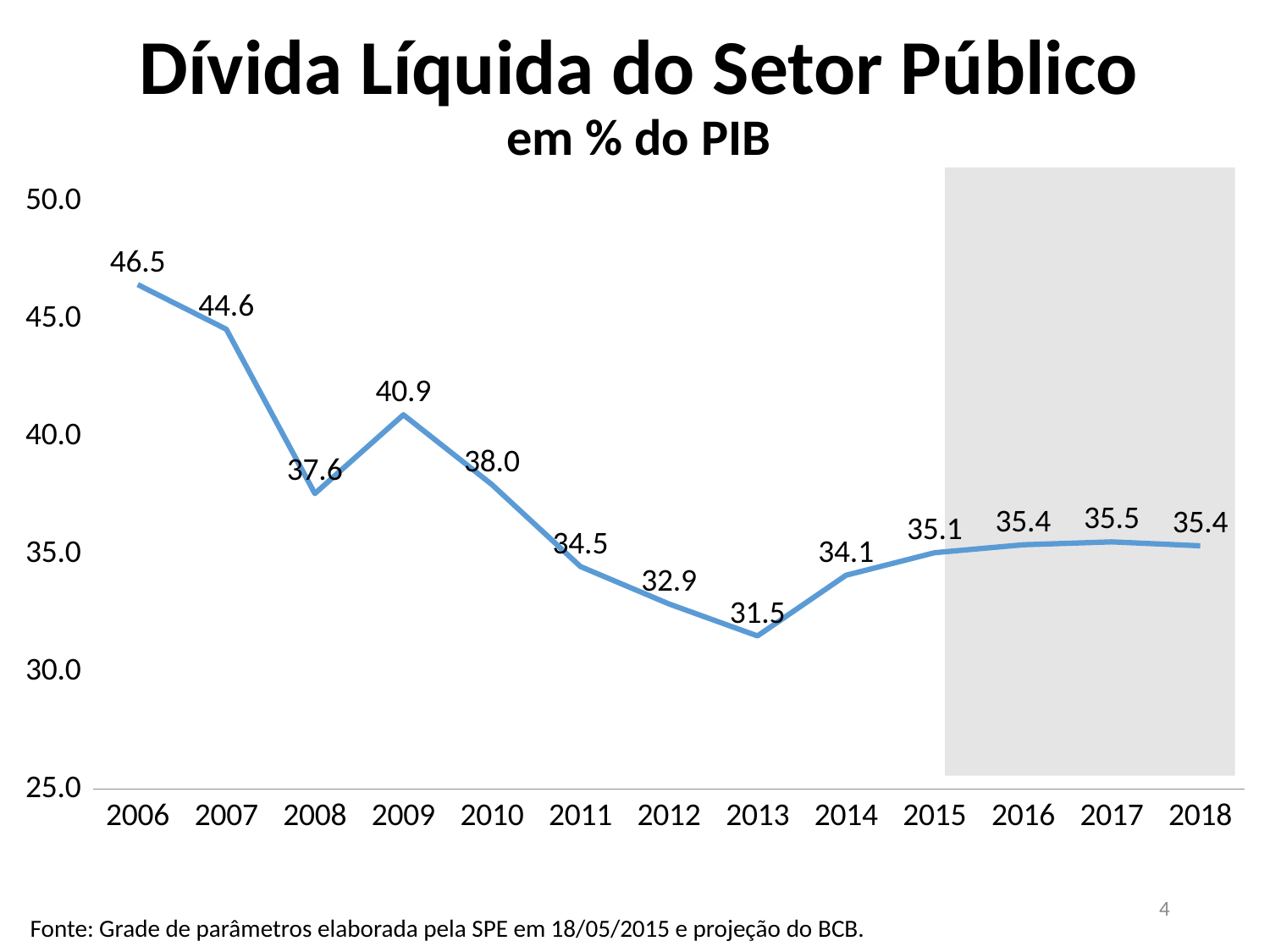
What is the value for 2017? 35.5 What is the difference between the values for 2006 and 2013? 15.0 Which year has the lowest value? 2013 Is the value for 2012 greater or less than 35.0? less Which is larger, the value for 2010 or the value for 2014? 2010 What is the value for 2006? 46.5 What is the value for 2013? 31.5 How many years are shown on the x axis? 13 What is the difference between the values for 2008 and 2009? 3.3 Which year has the highest value? 2006 Do the values rise or fall from 2009 to 2013? fall What kind of chart is this? line chart